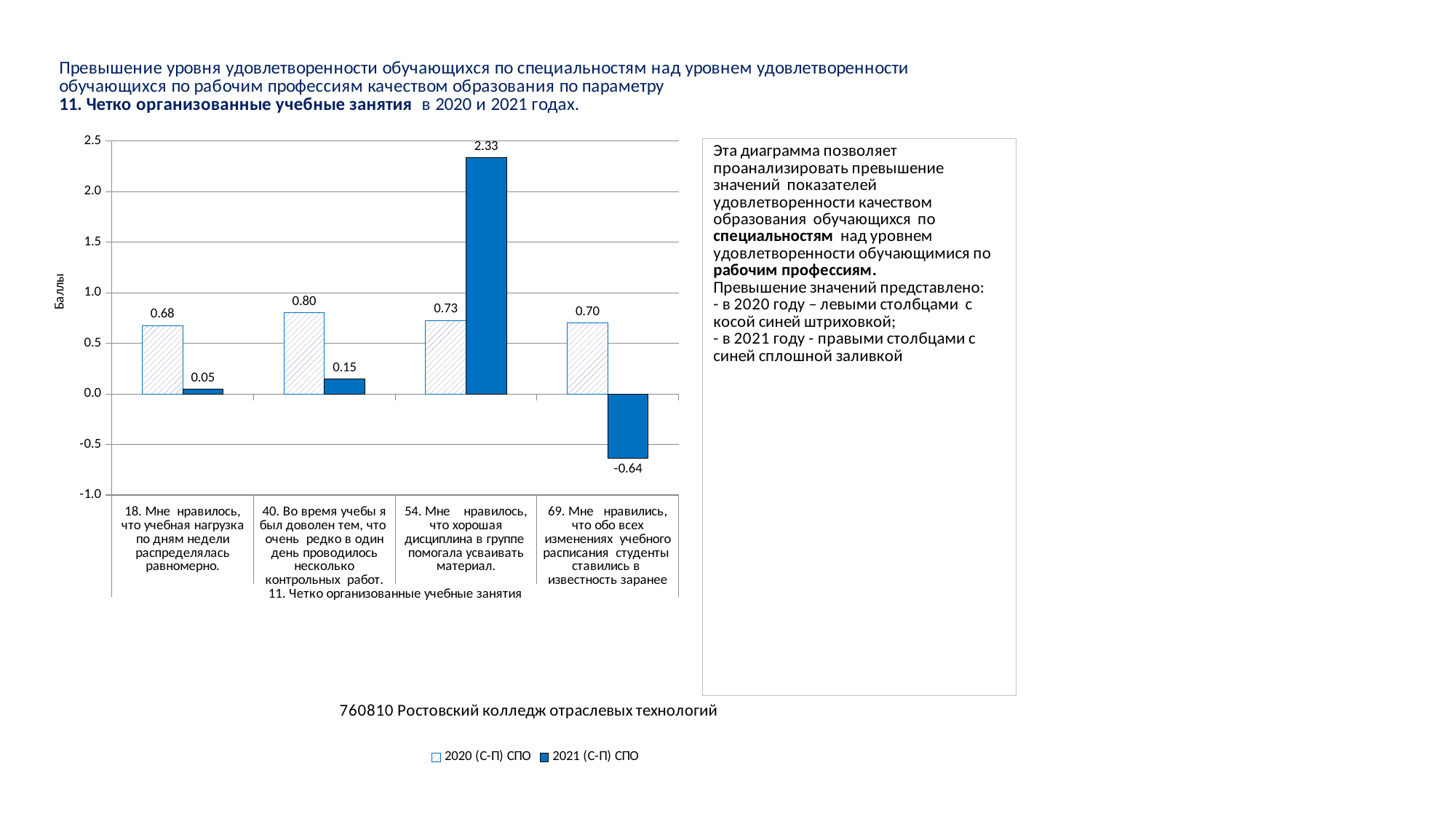
What is the difference between the 2021 (С-П) СПО and 2020 (С-П) СПО values for category 54? 1.60 What is the value of the 2020 (С-П) СПО series for category 40 ("Во время учебы я был доволен тем, что очень редко в один день проводилось несколько контрольных работ")? 0.80 Which category has the lowest value in the 2021 (С-П) СПО series? 69. Мне нравились, что обо всех изменениях учебного расписания студенты ставились в известность заранее For category 40, which series has the larger value: 2020 (С-П) СПО or 2021 (С-П) СПО? 2020 (С-П) СПО What is the label of the vertical axis of the chart? Баллы What is the value of the 2021 (С-П) СПО series for category 69 ("Мне нравились, что обо всех изменениях учебного расписания студенты ставились в известность заранее")? -0.64 Which category has the highest value in the 2021 (С-П) СПО series? 54. Мне нравилось, что хорошая дисциплина в группе помогала усваивать материал. What is the value of the 2020 (С-П) СПО series for category 18 ("Мне нравилось, что учебная нагрузка по дням недели распределялась равномерно")? 0.68 How many series does the chart legend list? 2 What is the value of the 2021 (С-П) СПО series for category 54 ("Мне нравилось, что хорошая дисциплина в группе помогала усваивать материал")? 2.33 What type of chart is shown on the slide? Bar chart How many categories are shown on the x axis of the chart? 4